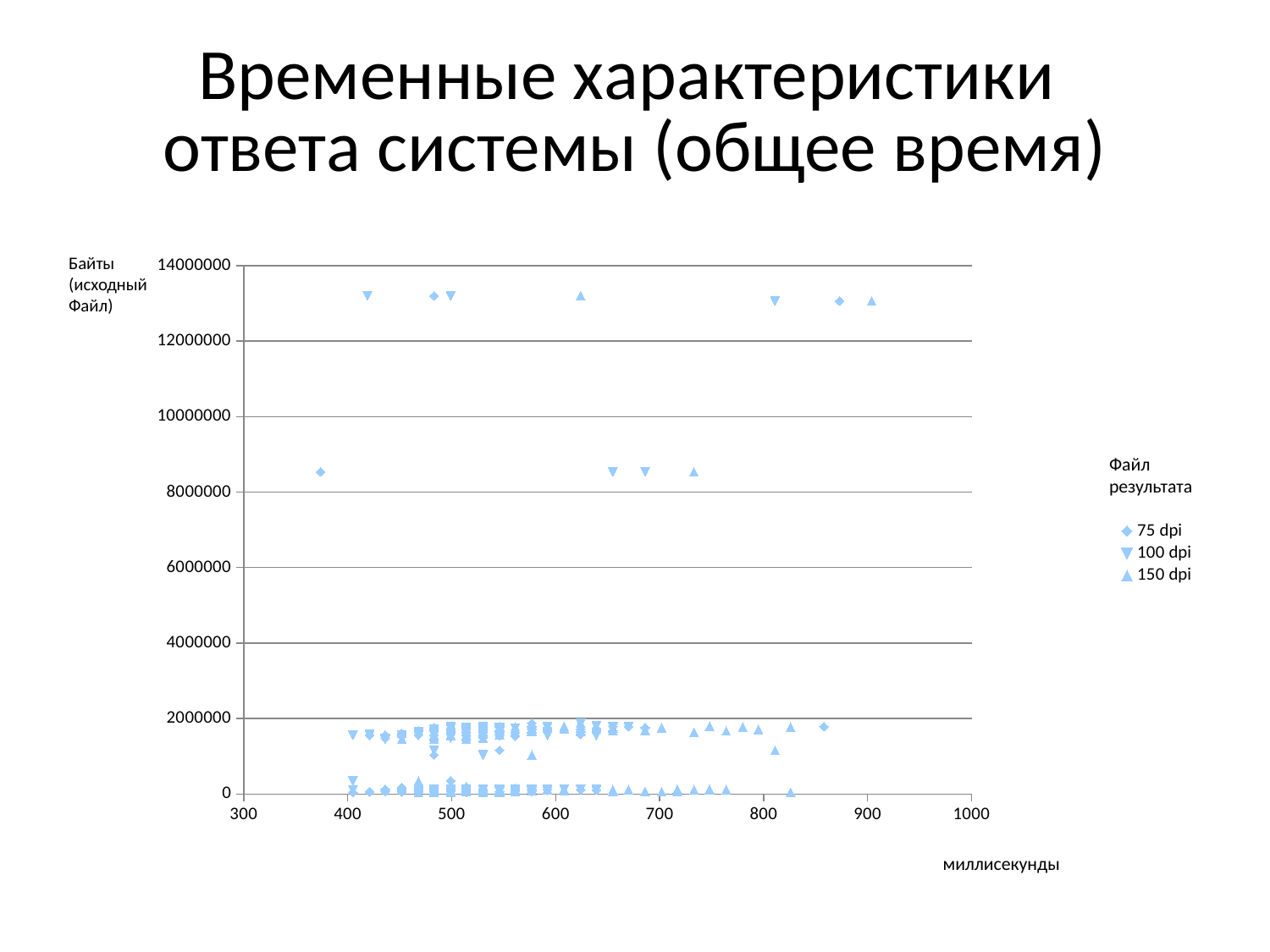
What is the label of the horizontal axis? миллисекунды Is the leftmost 75 dpi point (near 375 milliseconds) greater or less than 8000000 bytes? greater What kind of chart is shown on the slide? scatter chart Is the 75 dpi point near 860 milliseconds greater or less than 2000000 bytes? less Is the 150 dpi point near 810 milliseconds that lies below the main cluster greater or less than 2000000 bytes? less How many series does the legend list? 3 What are the three series named in the legend? 75 dpi, 100 dpi, 150 dpi